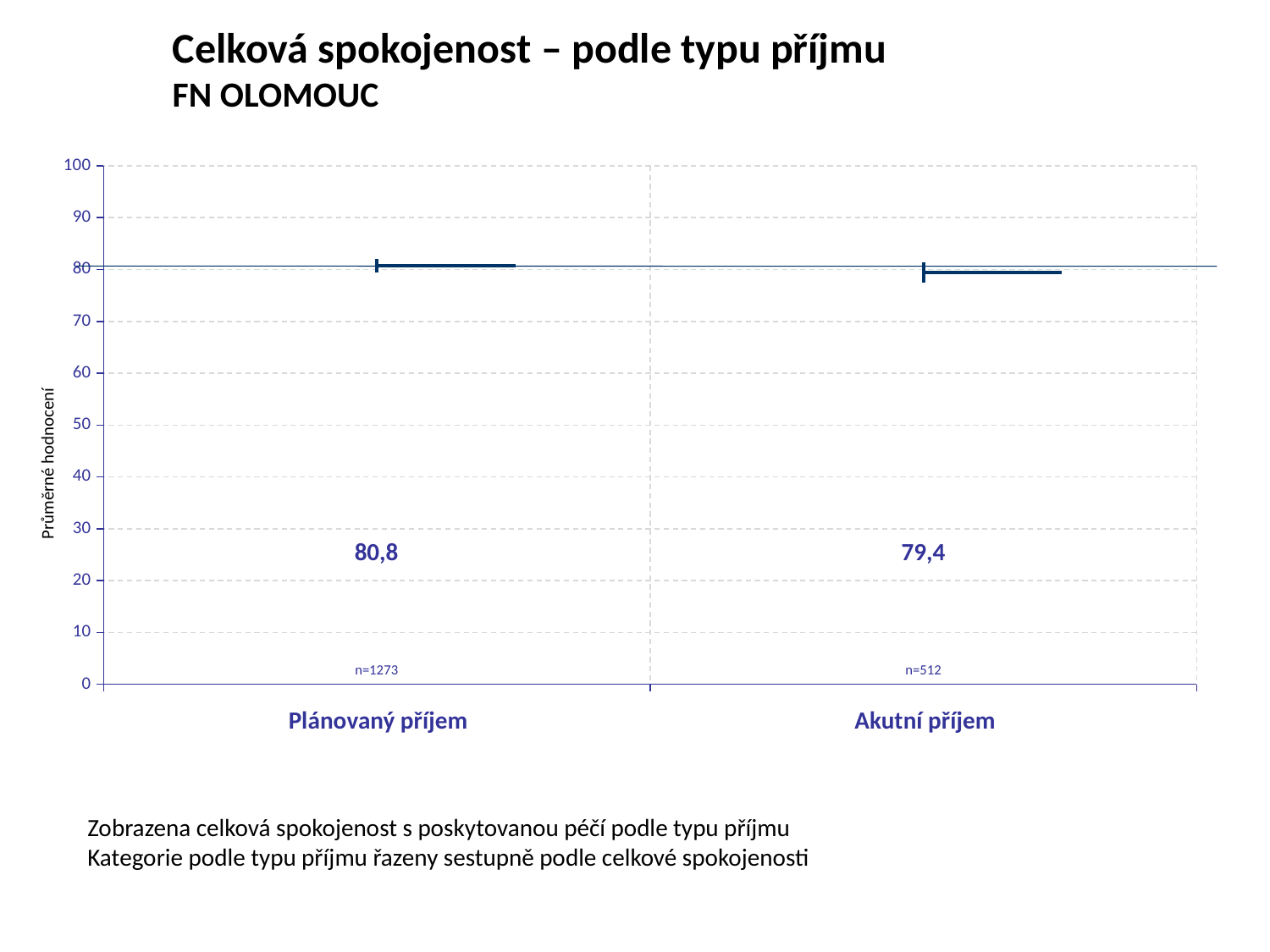
What is the sample size (n) for Akutní příjem? n=512 Is the value for Akutní příjem greater or less than 80? less What is the difference between the average ratings of Plánovaný příjem and Akutní příjem? 1,4 What is the average rating for Akutní příjem? 79,4 What is the label of the y axis? Průměrné hodnocení What is the average rating (Průměrné hodnocení) for Plánovaný příjem? 80,8 Which category has the lower average rating? Akutní příjem What is the title of the chart? Celková spokojenost – podle typu příjmu What is the sample size (n) for Plánovaný příjem? n=1273 Which category has the higher average rating? Plánovaný příjem Is the value for Plánovaný příjem greater or less than 80? greater How many categories are shown on the x axis? 2